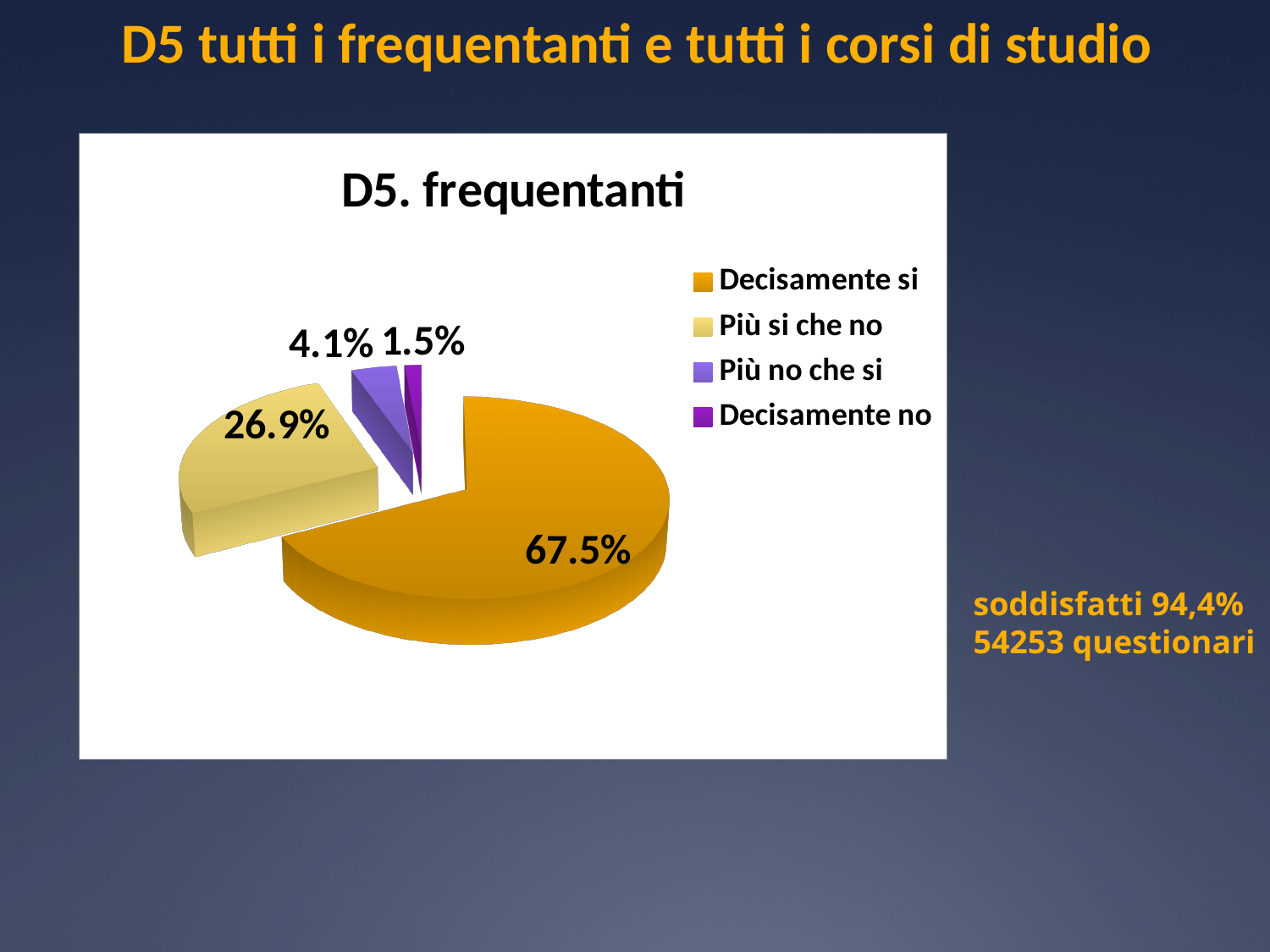
What kind of chart is shown on the slide? pie chart What share of the pie is 'Decisamente si'? 67.5% Which is larger, the 'Più no che si' slice or the 'Decisamente no' slice? Più no che si How many categories does the legend list? 4 What is the difference between the 'Decisamente si' and 'Più si che no' shares? 40.6% What colour is the 'Decisamente si' slice? orange What is the chart's title? D5. frequentanti What share of the pie is 'Decisamente no'? 1.5% What share of the pie is 'Più no che si'? 4.1% Which category has the smallest slice? Decisamente no Which category has the largest slice? Decisamente si